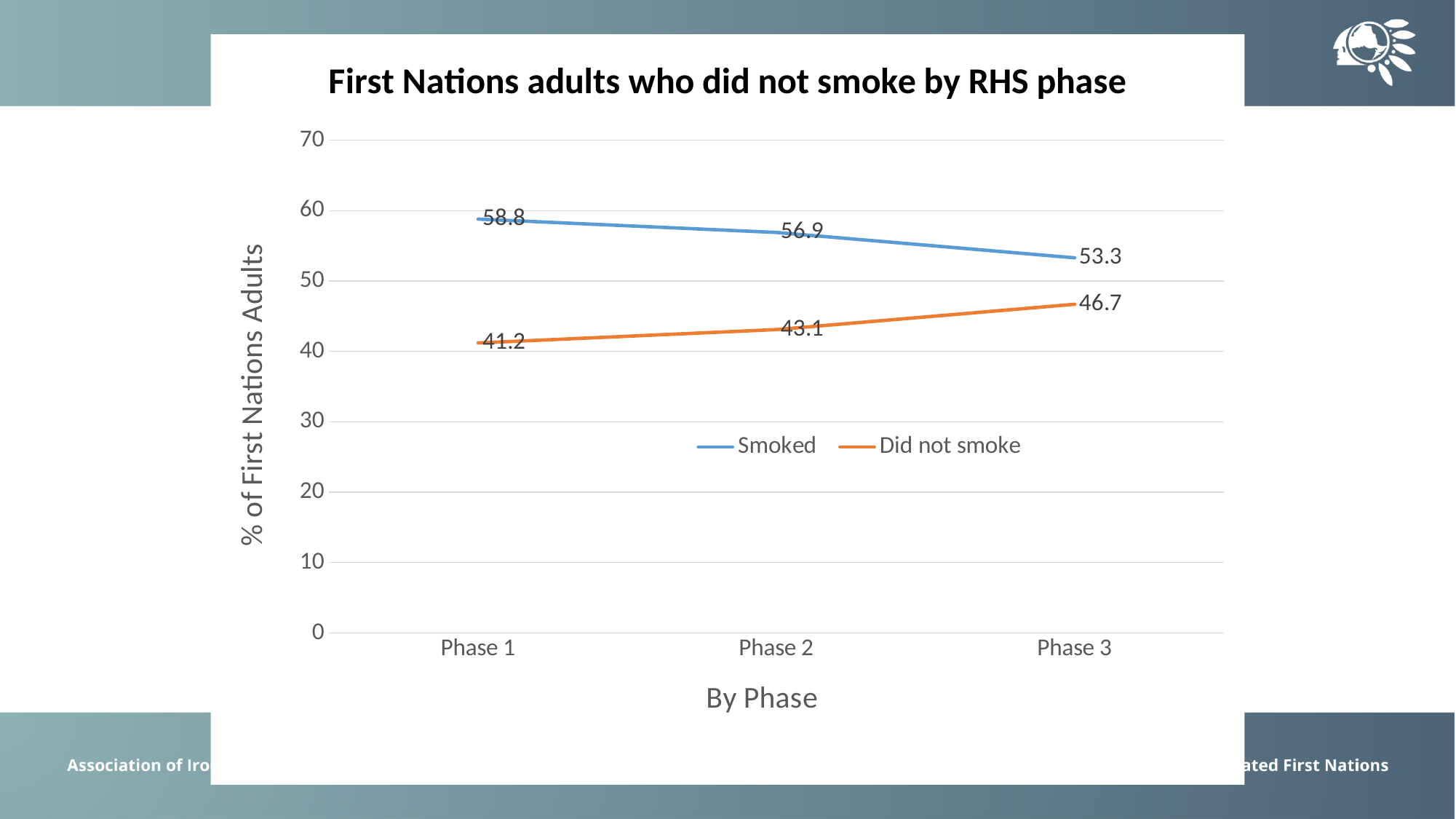
Which is larger in Phase 2, Smoked or Did not smoke? Smoked What is the value for Did not smoke in Phase 3? 46.7 In which phase is the Did not smoke value highest? Phase 3 In which phase is the Smoked value lowest? Phase 3 Does the Smoked line rise or fall from Phase 1 to Phase 3? Fall What is the value for Did not smoke in Phase 2? 43.1 By how much did the Did not smoke value change from Phase 1 to Phase 3? 5.5 What is the difference between the Smoked and Did not smoke values in Phase 1? 17.6 What type of chart is shown on the slide? Line chart How many phases are shown on the x axis? 3 What is the value for Smoked in Phase 1? 58.8 How many series does the legend list? 2